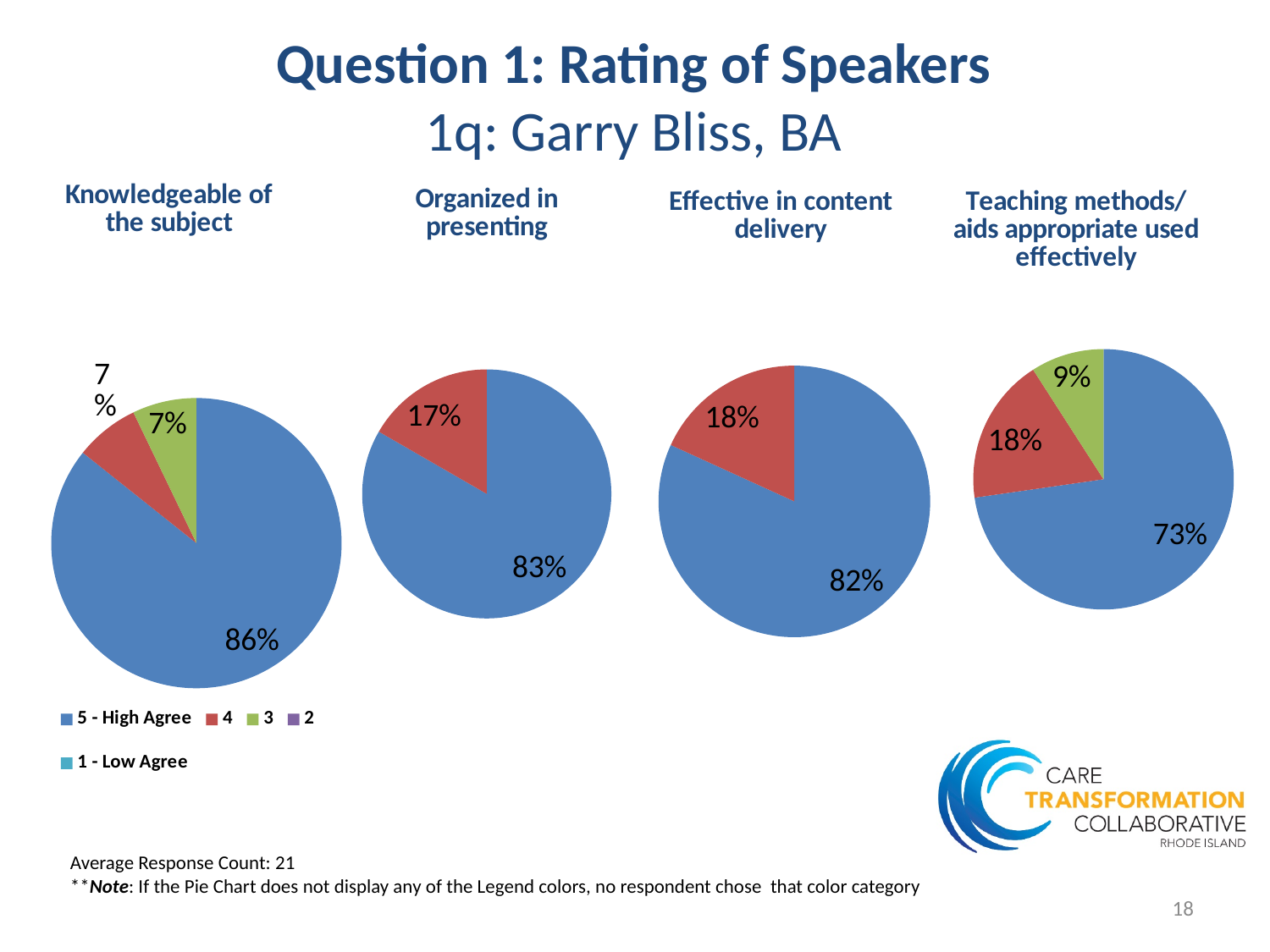
In the 'Knowledgeable of the subject' pie chart, what share of respondents chose '5 - High Agree'? 86% In the 'Teaching methods/aids appropriate used effectively' pie chart, what share of respondents chose '4'? 18% In the 'Effective in content delivery' pie chart, what share of respondents chose '5 - High Agree'? 82% Which is larger: the '4' share in the 'Organized in presenting' chart or the '4' share in the 'Effective in content delivery' chart? Effective in content delivery In the 'Teaching methods/aids appropriate used effectively' pie chart, what share of respondents chose '3'? 9% Across the four pie charts, which category has the largest '5 - High Agree' share? Knowledgeable of the subject How many pie charts are shown on the slide? 4 In the 'Organized in presenting' pie chart, what share of respondents chose '4'? 17% How many entries does the legend list? 5 Across the four pie charts, which category has the smallest '5 - High Agree' share? Teaching methods/aids appropriate used effectively What is the difference between the '5 - High Agree' share in the 'Knowledgeable of the subject' chart and in the 'Teaching methods/aids appropriate used effectively' chart? 13% What kind of charts are shown on the slide? Pie charts